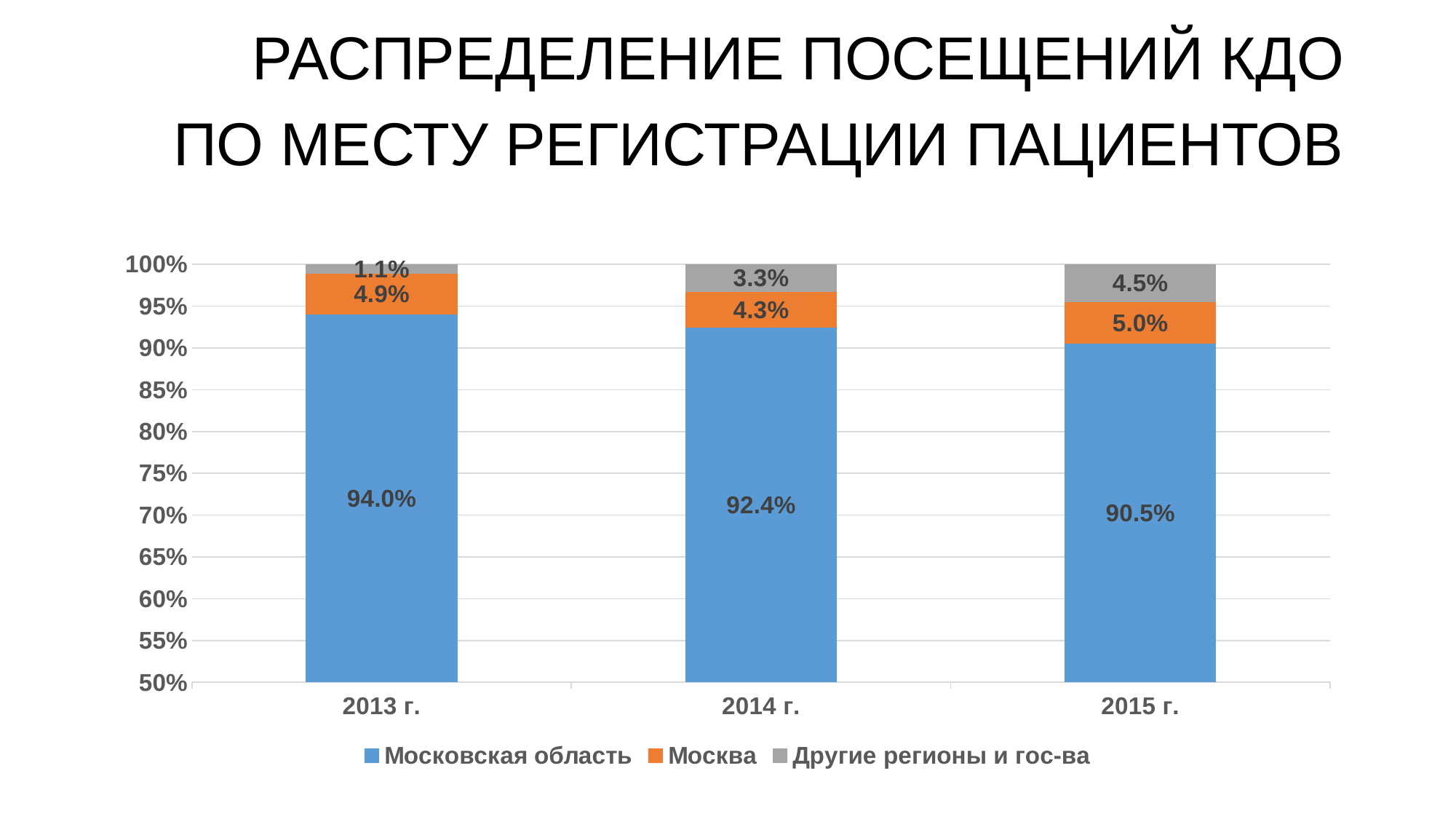
What is the value for Московская область in 2013 г.? 94.0% In which year is the value for Московская область the lowest? 2015 г. In which year is the value for Другие регионы и гос-ва the highest? 2015 г. What is the value for Другие регионы и гос-ва in 2013 г.? 1.1% What is the value for Москва in 2014 г.? 4.3% Which is larger: the Москва value in 2013 г. or in 2014 г.? 2013 г. What kind of chart is shown on the slide? stacked bar chart What is the difference between the Московская область values for 2013 г. and 2015 г.? 3.5% How many years are shown on the x axis? 3 How many series does the legend list? 3 What is the value for Другие регионы и гос-ва in 2015 г.? 4.5% Does the value for Московская область rise or fall from 2013 г. to 2015 г.? fall